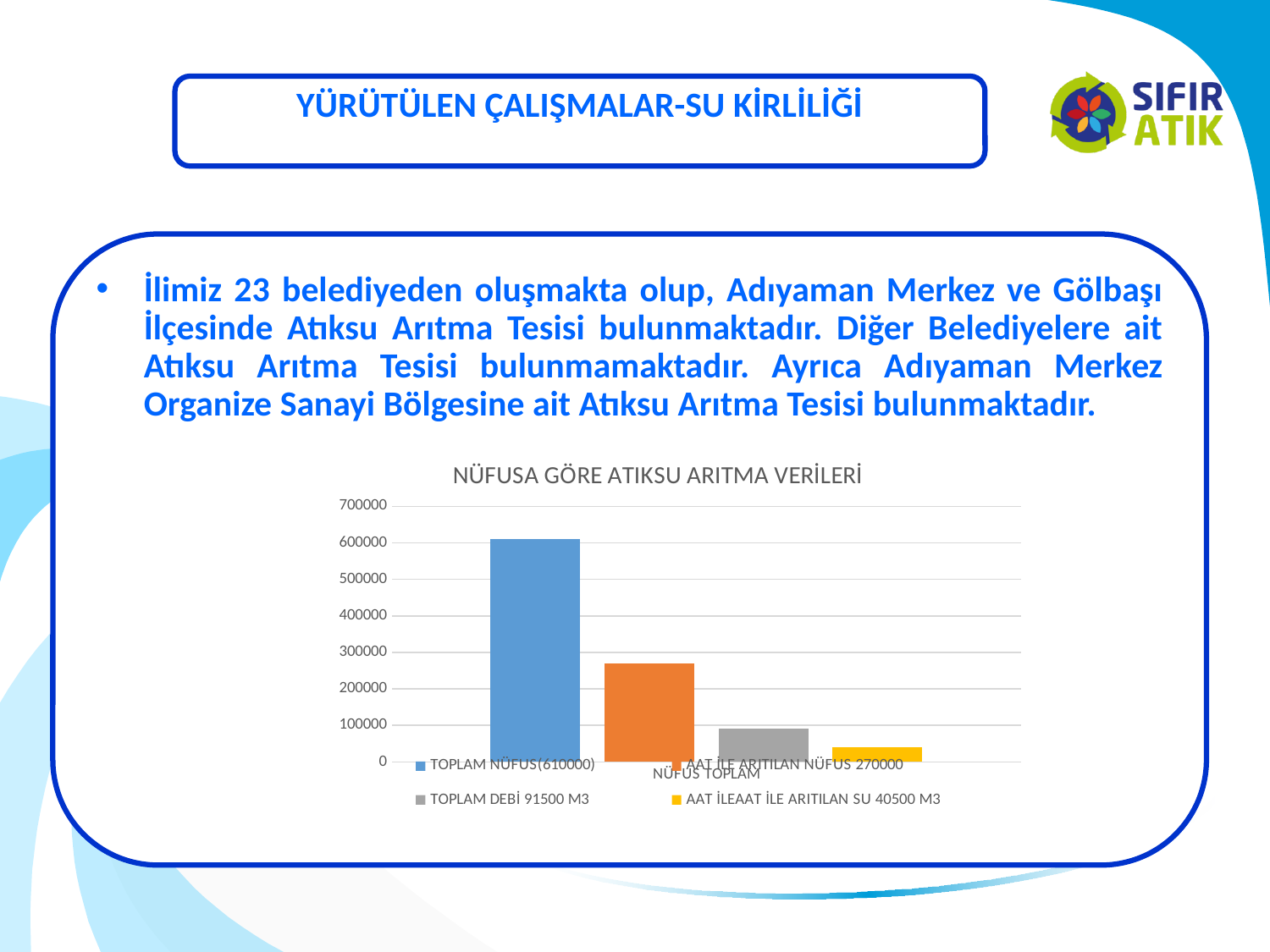
Is the value of the TOPLAM NÜFUS bar greater or less than 500000? greater Which series has the shortest bar in the chart? AAT İLEAAT İLE ARITILAN SU 40500 M3 What value does the legend give for TOPLAM DEBİ? 91500 M3 Is the value of the AAT İLE ARITILAN NÜFUS bar greater or less than 300000? less What colour is the TOPLAM NÜFUS bar in the chart? blue Is the value of the TOPLAM DEBİ bar greater or less than 100000? less What kind of chart is shown on the slide? bar chart How many series does the legend of the chart list? 4 Which bar is taller: AAT İLE ARITILAN NÜFUS or TOPLAM DEBİ? AAT İLE ARITILAN NÜFUS What is the title of the chart? NÜFUSA GÖRE ATIKSU ARITMA VERİLERİ Which series has the tallest bar in the chart? TOPLAM NÜFUS(610000) How many categories are shown on the x axis of the chart? 1